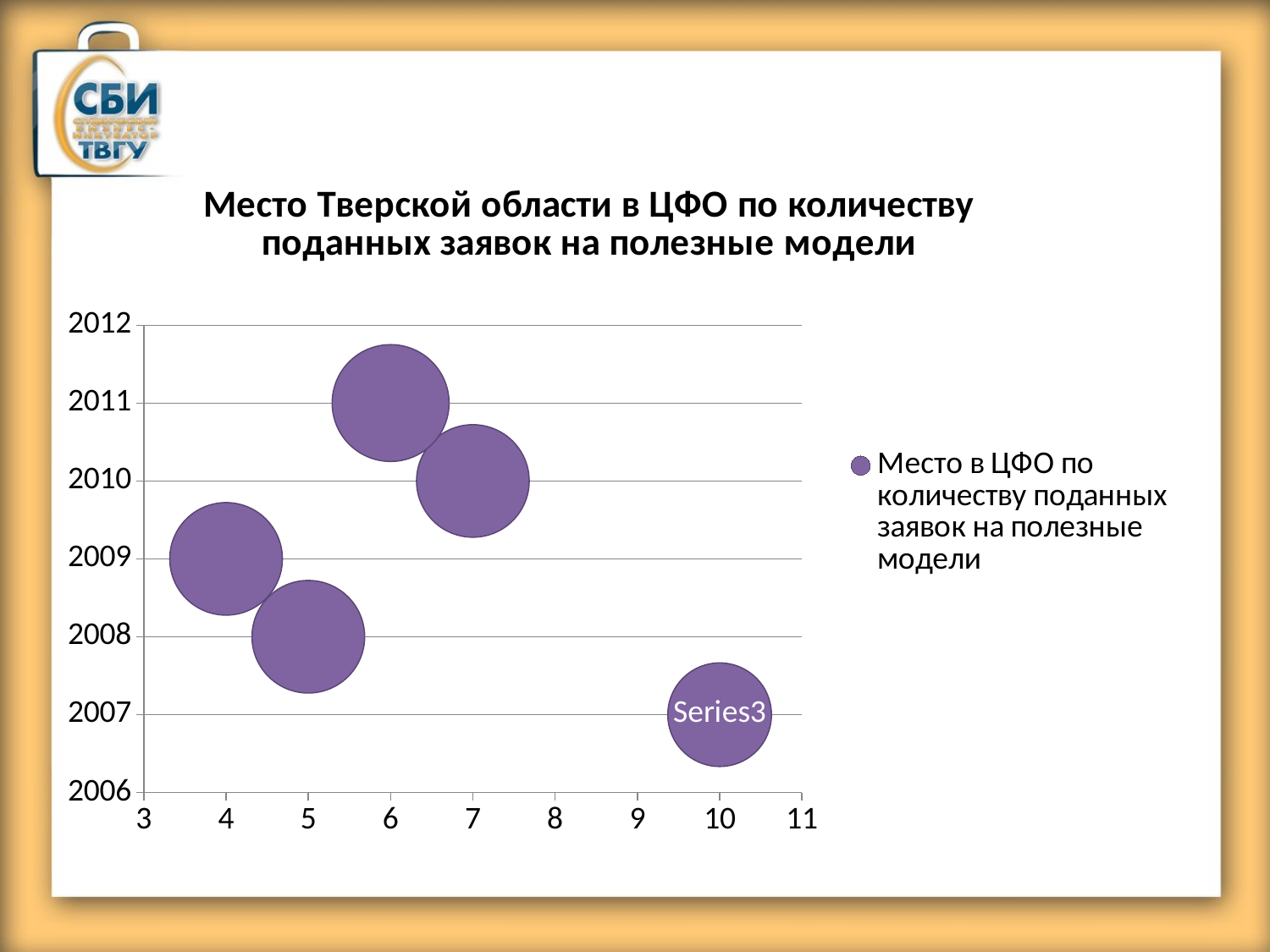
How many series does the legend list? 1 What place (x-axis value) does the bubble for 2007 land on? 10 What type of chart is shown on the slide? Bubble chart Which year has the bubble with the highest x-axis value? 2007 Which year has the bubble with the lowest x-axis value? 2009 How many bubbles are plotted on the chart? 5 What is the difference between the x-axis values of the bubbles for 2007 and 2009? 6 What place (x-axis value) does the bubble for 2009 land on? 4 What place (x-axis value) does the bubble for 2011 land on? 6 What place (x-axis value) does the bubble for 2008 land on? 5 What place (x-axis value) does the bubble for 2010 land on? 7 What is the title of the chart? Место Тверской области в ЦФО по количеству поданных заявок на полезные модели